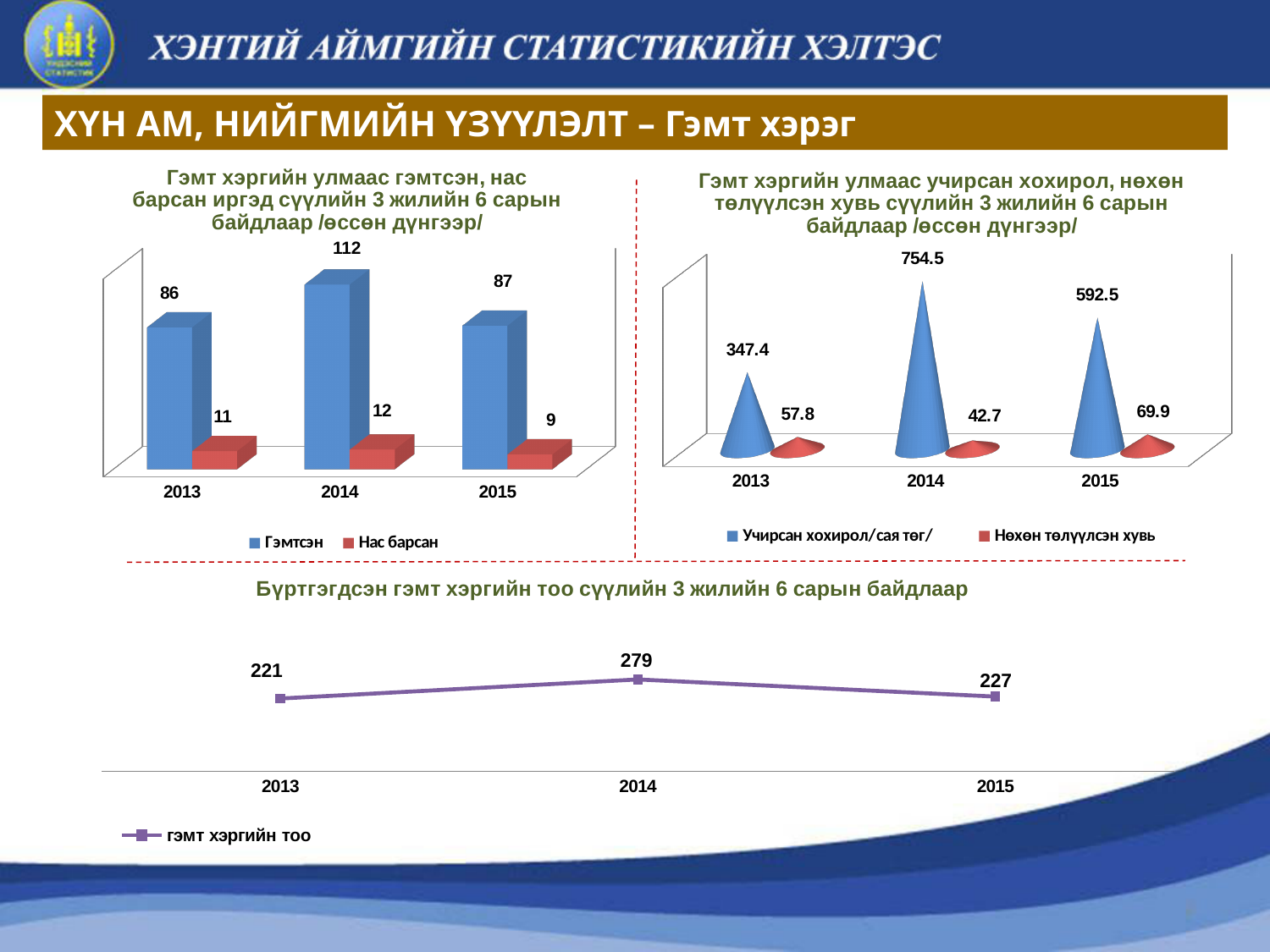
In the top-right chart, what is the value for Нөхөн төлүүлсэн хувь in 2015? 69.9 In the top-left chart, what is the difference between the Гэмтсэн values for 2014 and 2013? 26 In the top-left chart, what is the value for Гэмтсэн in 2014? 112 In the top-left chart, which year has the highest value for Гэмтсэн? 2014 In the top-right chart, what is the value for Учирсан хохирол/сая төг/ in 2014? 754.5 In the top-right chart, is the Учирсан хохирол/сая төг/ value for 2015 larger or smaller than the value for 2013? larger In the top-left chart, how many series does the legend list? 2 In the top-right chart, which year has the lowest value for Нөхөн төлүүлсэн хувь? 2014 In the top-left chart, what is the value for Нас барсан in 2015? 9 In the bottom chart, how many years are plotted? 3 In the bottom chart, what is the value for гэмт хэргийн тоо in 2014? 279 What kind of chart is the top-left chart? bar chart